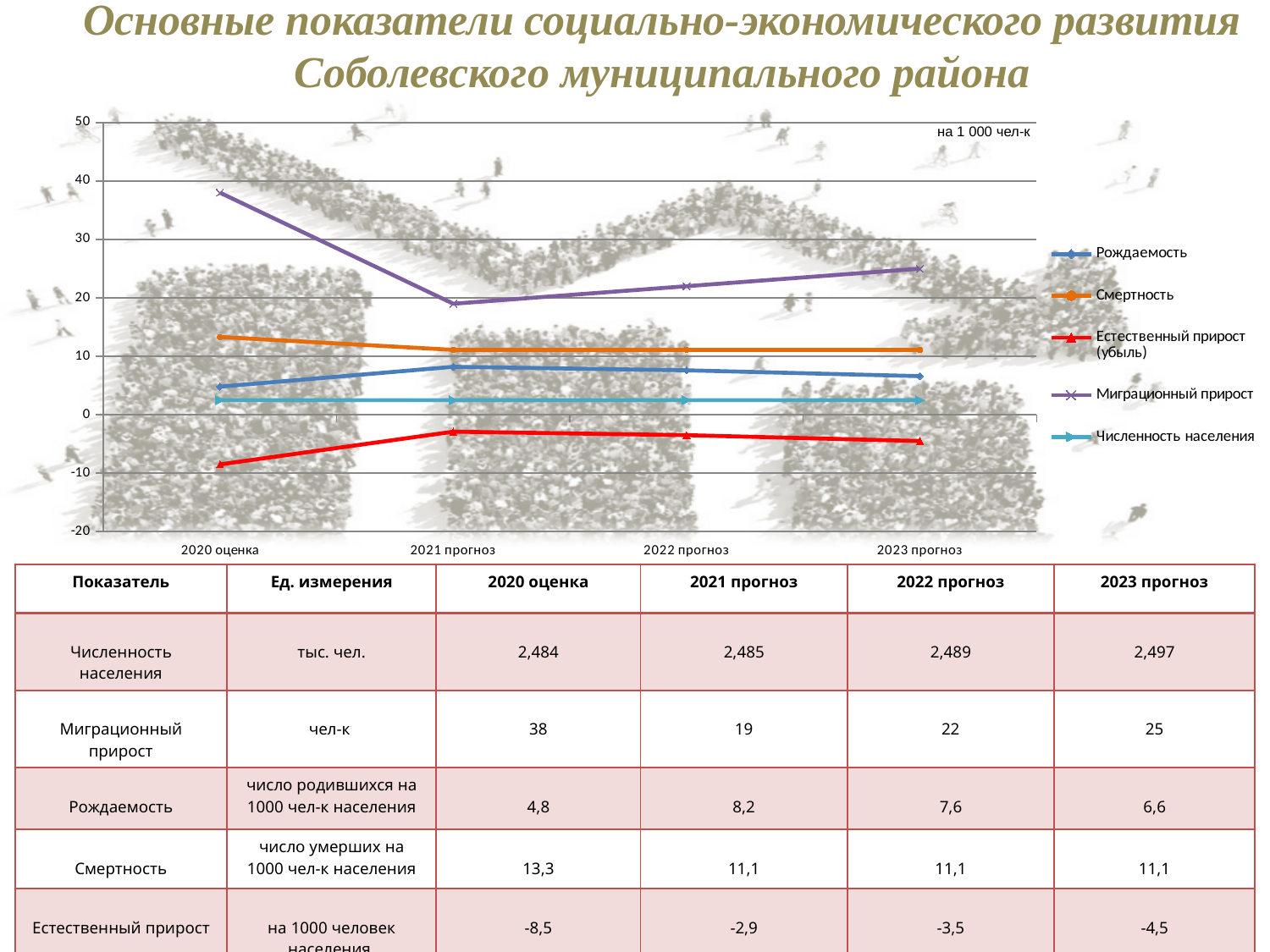
How many categories are shown along the x axis of the chart? 4 What kind of chart is shown on the slide? line chart In which period is Миграционный прирост highest? 2020 оценка What unit note is printed in the top right corner of the chart area? на 1 000 чел-к What is the value of Миграционный прирост for 2020 оценка? 38 What is the value of Смертность for 2023 прогноз? 11,1 What is the difference between Миграционный прирост in 2020 оценка and 2021 прогноз? 19 In which period is Естественный прирост (убыль) lowest? 2020 оценка Is the value for Миграционный прирост in 2023 прогноз greater or less than 20? greater Which is larger in 2021 прогноз: Рождаемость or Смертность? Смертность How many series does the chart legend list? 5 Does Рождаемость rise or fall from 2021 прогноз to 2023 прогноз? fall